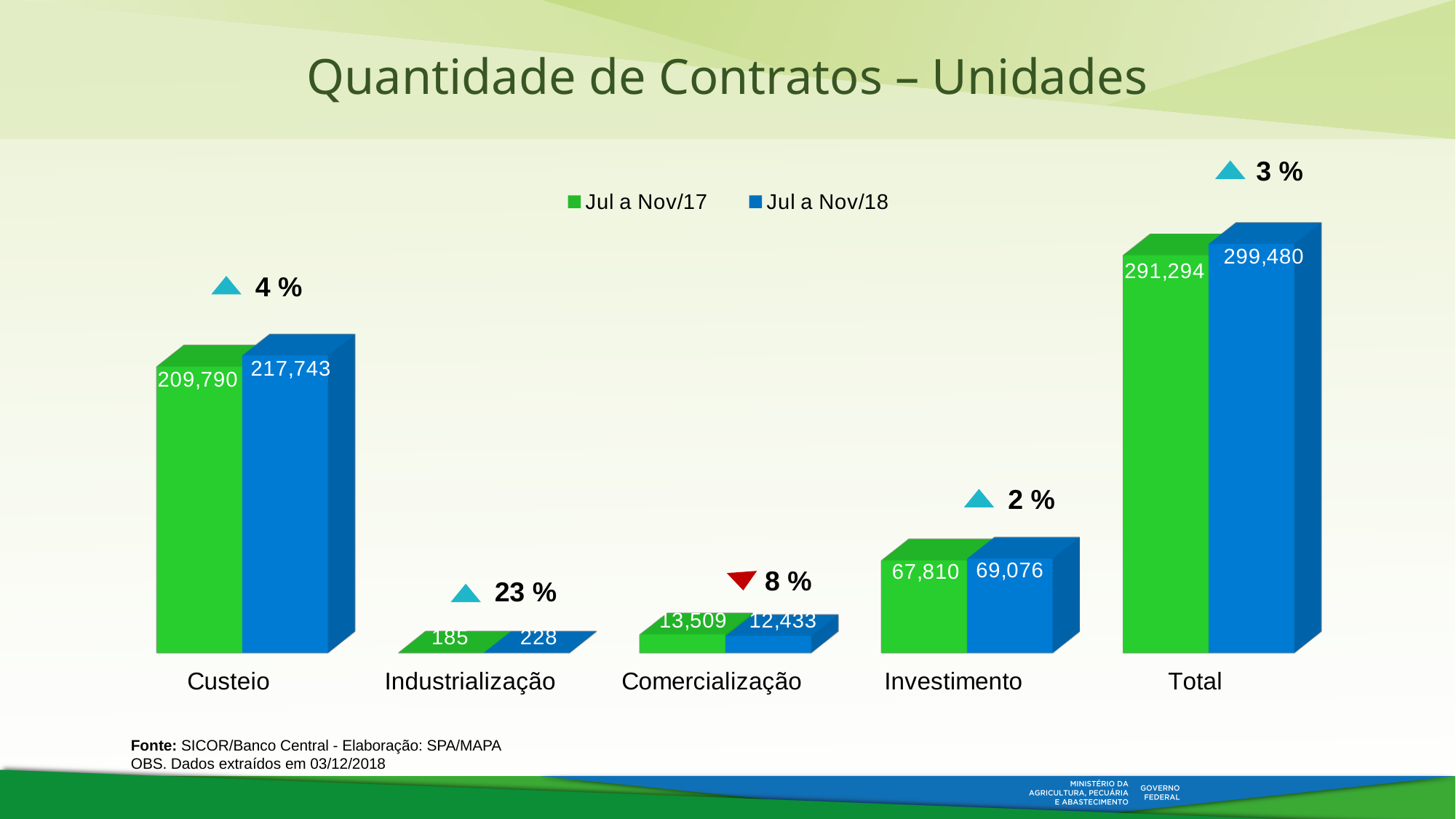
What is the value for Industrialização in the Jul a Nov/18 series? 228 Excluding Total, which category has the highest value in the Jul a Nov/18 series? Custeio What is the difference between the Jul a Nov/18 and Jul a Nov/17 values for Custeio? 7,953 How many series does the legend list? 2 For Comercialização, which series has the larger value, Jul a Nov/17 or Jul a Nov/18? Jul a Nov/17 What kind of chart is shown on the slide? Bar chart Which category has the lowest value in the Jul a Nov/17 series? Industrialização What is the title of the chart? Quantidade de Contratos – Unidades How many categories are shown on the x axis? 5 What percentage change is shown above the Industrialização bars? 23 % What is the value for Investimento in the Jul a Nov/17 series? 67,810 What is the value for Custeio in the Jul a Nov/18 series? 217,743